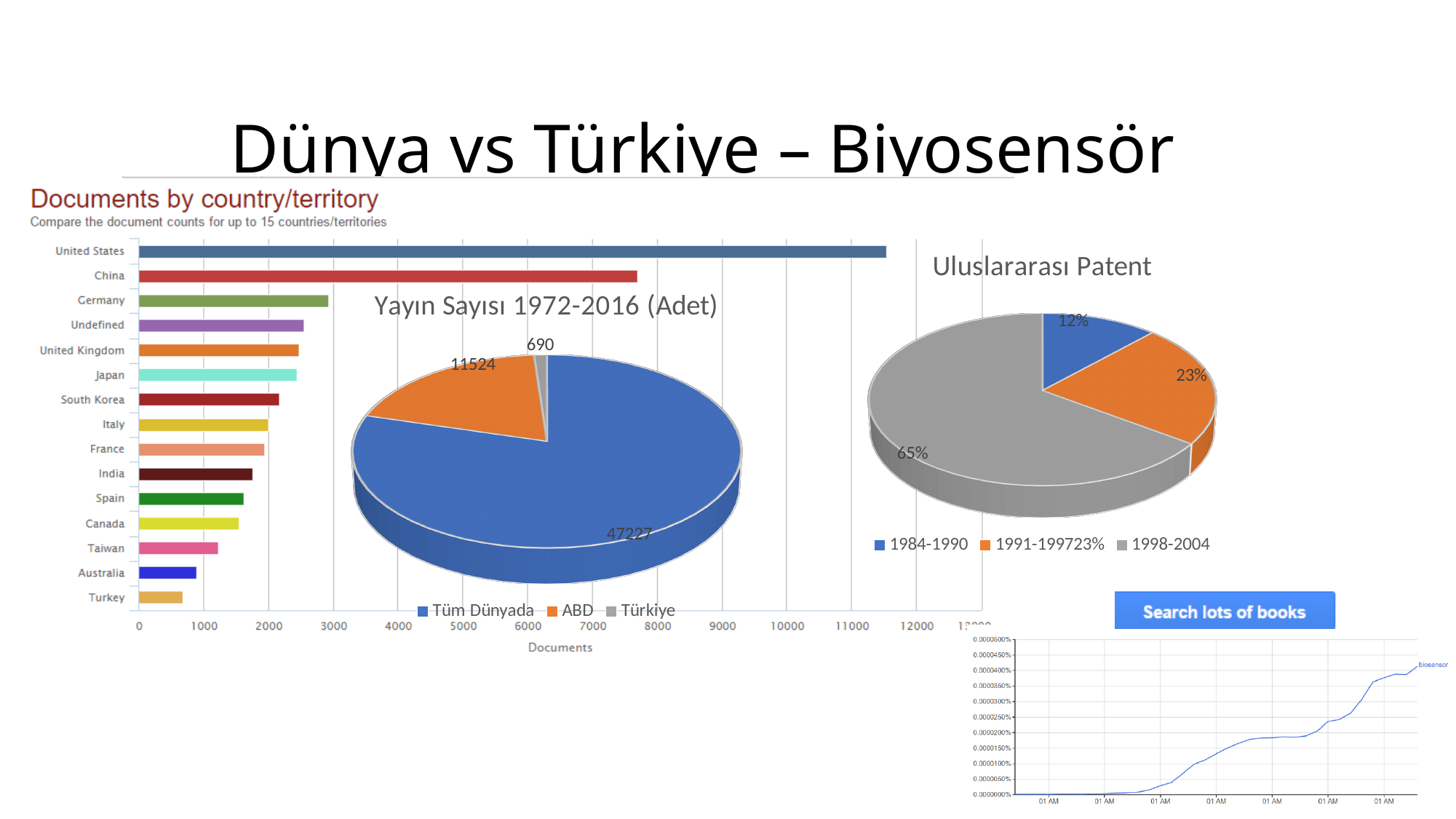
In the 'Uluslararası Patent' pie chart, what share does 1984-1990 have? 12% In the 'Documents by country/territory' chart, which country has the highest document count? United States In the 'Documents by country/territory' chart, which has more documents, Germany or South Korea? Germany In the 'Documents by country/territory' chart, which country has the lowest document count? Turkey In the 'Yayın Sayısı 1972-2016 (Adet)' pie chart, what is the value for Türkiye? 690 In the 'Documents by country/territory' chart, is the value for Turkey greater or less than 1000? less In the 'Documents by country/territory' chart, is the value for China greater or less than 7000? greater In the 'Uluslararası Patent' pie chart, what share does 1998-2004 have? 65% In the 'Yayın Sayısı 1972-2016 (Adet)' pie chart, what is the difference between Tüm Dünyada and ABD? 35703 In the 'Documents by country/territory' chart, how many countries/territories are listed? 15 What kind of chart is the 'Documents by country/territory' chart? bar chart In the 'Yayın Sayısı 1972-2016 (Adet)' pie chart, what is the value for ABD? 11524